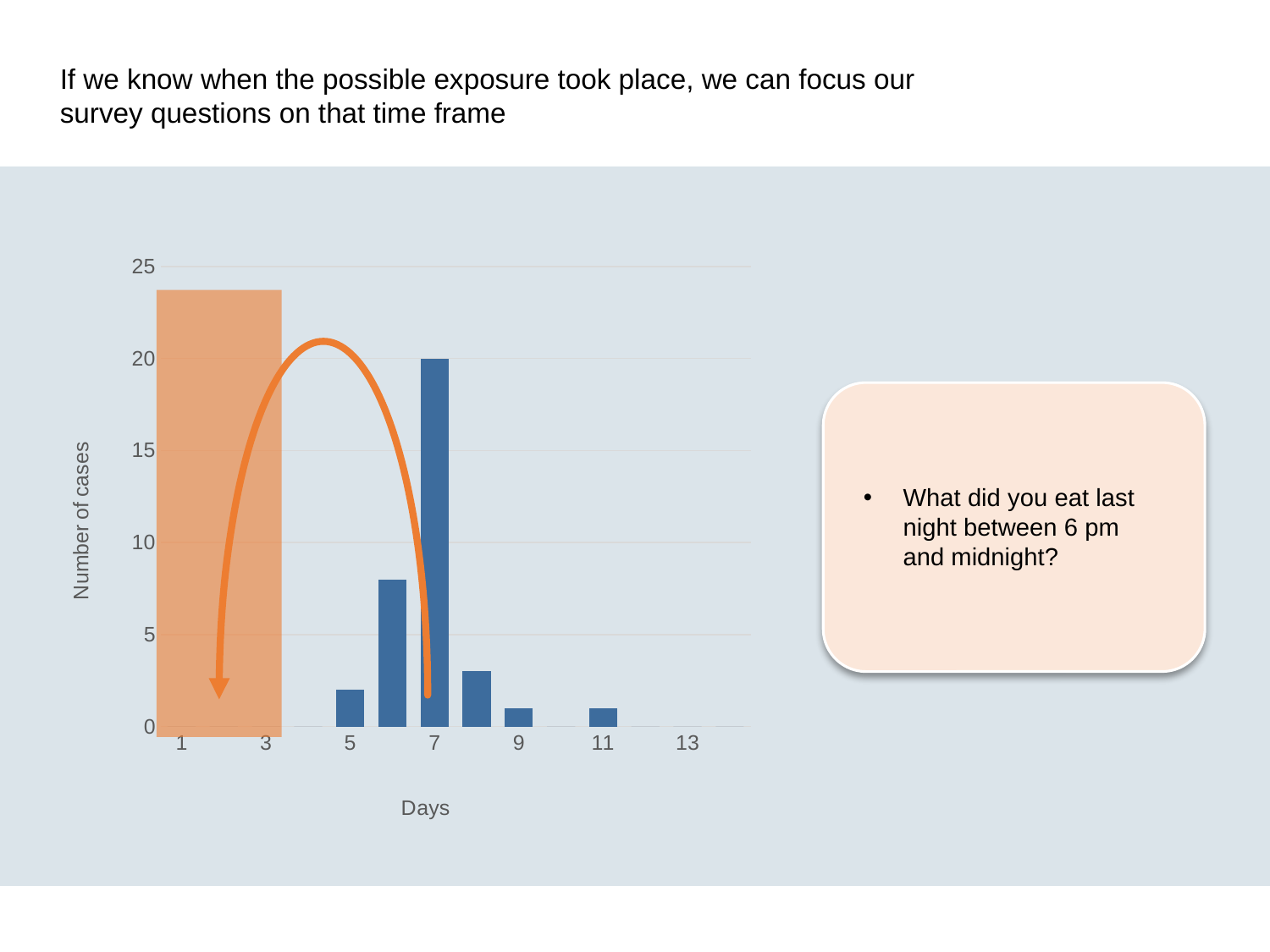
What is the number of cases on day 7? 20 Is the number of cases on day 6 greater or less than 5? greater What is the label of the y axis? Number of cases How many days have a visible bar in the chart? 6 Is the number of cases on day 8 greater or less than 5? less Is the number of cases on day 6 greater or less than 10? less Which day has more cases, day 6 or day 8? day 6 What is the label of the x axis? Days Which day has more cases, day 7 or day 6? day 7 What type of chart is shown on the slide? bar chart On which day is the number of cases highest? 7